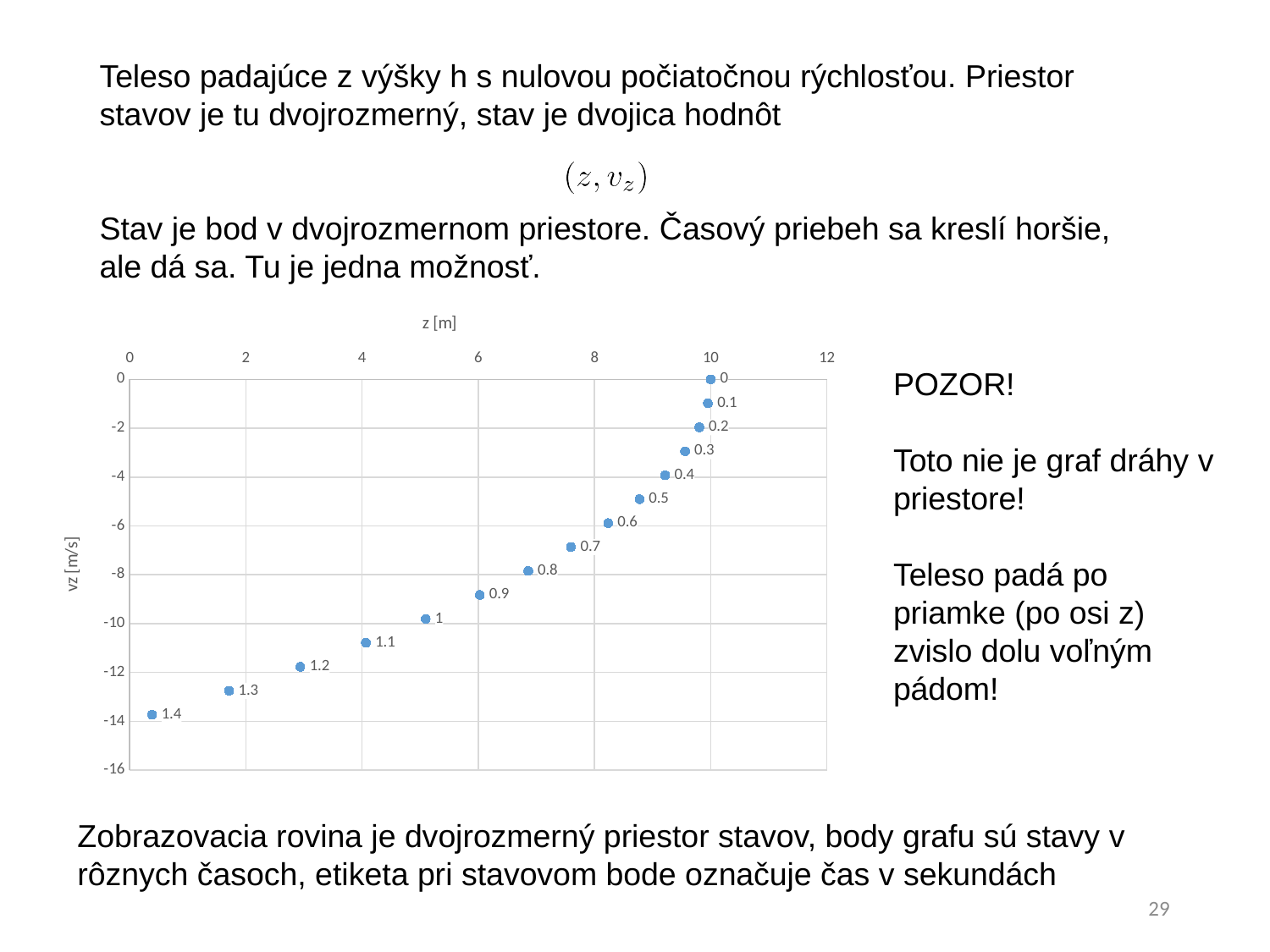
What is the title of the vertical axis of the chart? vz [m/s] What kind of chart is shown on the slide? scatter chart Is the vz value for the point labelled 1.4 greater or less than -12? less How many data points are plotted in the chart? 15 Which labelled point has the lowest vz value? 1.4 Which labelled point has the highest vz value? 0 What is the title of the horizontal axis of the chart? z [m] Which point has the larger z value, the one labelled 0.3 or the one labelled 0.9? 0.3 As z increases along the x axis, do the vz values of the points rise or fall? rise Is the z value for the point labelled 1 greater or less than 6? less Is the vz value for the point labelled 0.5 greater or less than -6? greater